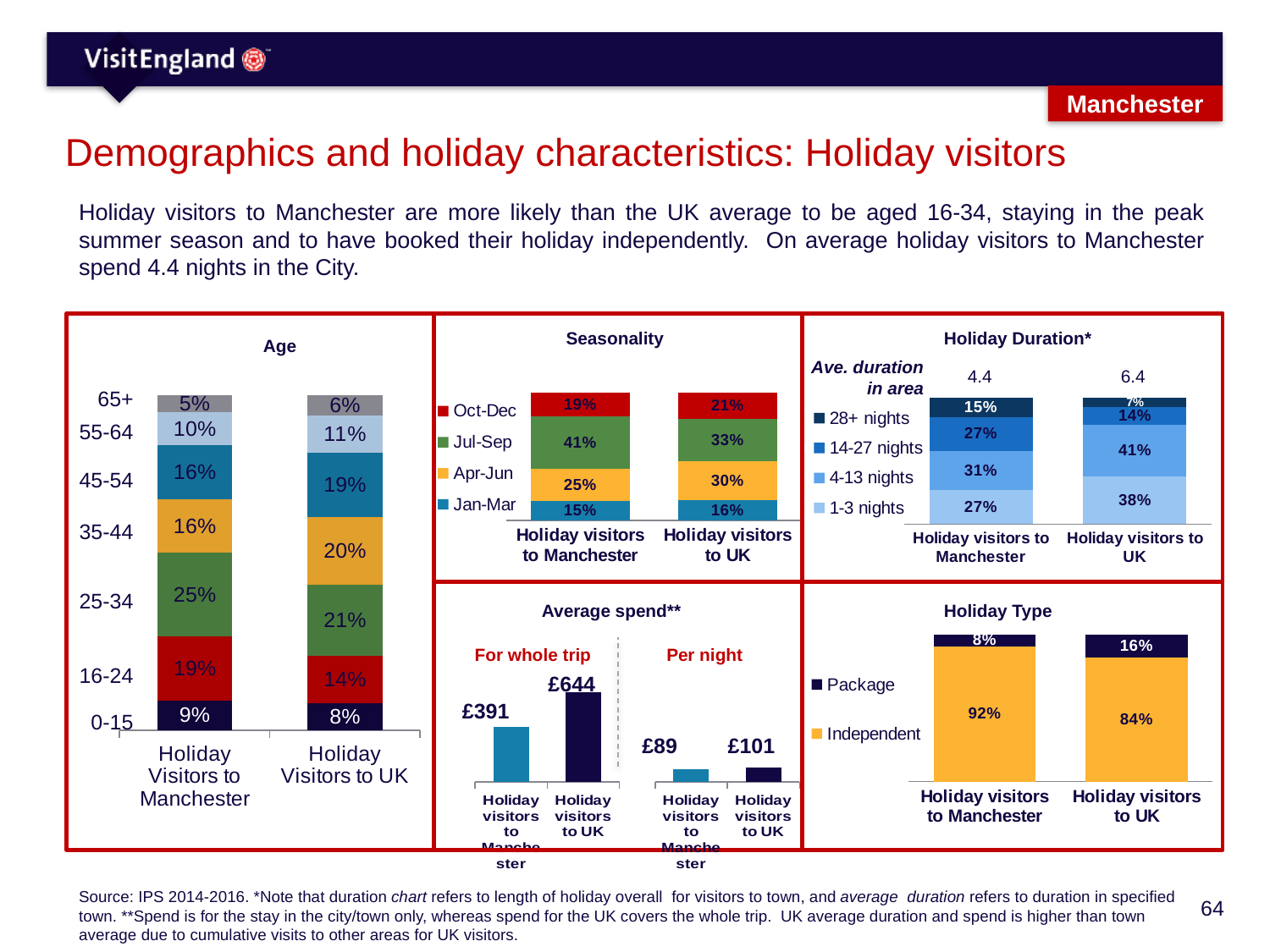
In the Holiday Type chart, what percentage of holiday visitors to Manchester booked a package holiday? 8% In the Seasonality chart, which is larger: the Apr-Jun share for holiday visitors to Manchester or for holiday visitors to UK? Holiday visitors to UK In the Age chart, which age group is the largest share of holiday visitors to Manchester? 25-34 In the Average spend chart, what is the difference between the per night spend for holiday visitors to UK and holiday visitors to Manchester? £12 In the Seasonality chart, what percentage of holiday visitors to Manchester visit in Jul-Sep? 41% In the Holiday Duration chart, what percentage of holiday visitors to UK stay 4-13 nights? 41% What type of chart is the Holiday Type chart? Stacked bar chart In the Average spend chart, what is the spend for the whole trip for holiday visitors to UK? £644 In the Holiday Duration chart, what is the average duration in area shown for holiday visitors to Manchester? 4.4 In the Age chart, what is the difference between the 16-24 share for holiday visitors to Manchester and for holiday visitors to UK? 5% In the Seasonality chart, how many series does the legend list? 4 In the Age chart, what percentage of holiday visitors to Manchester are aged 25-34? 25%